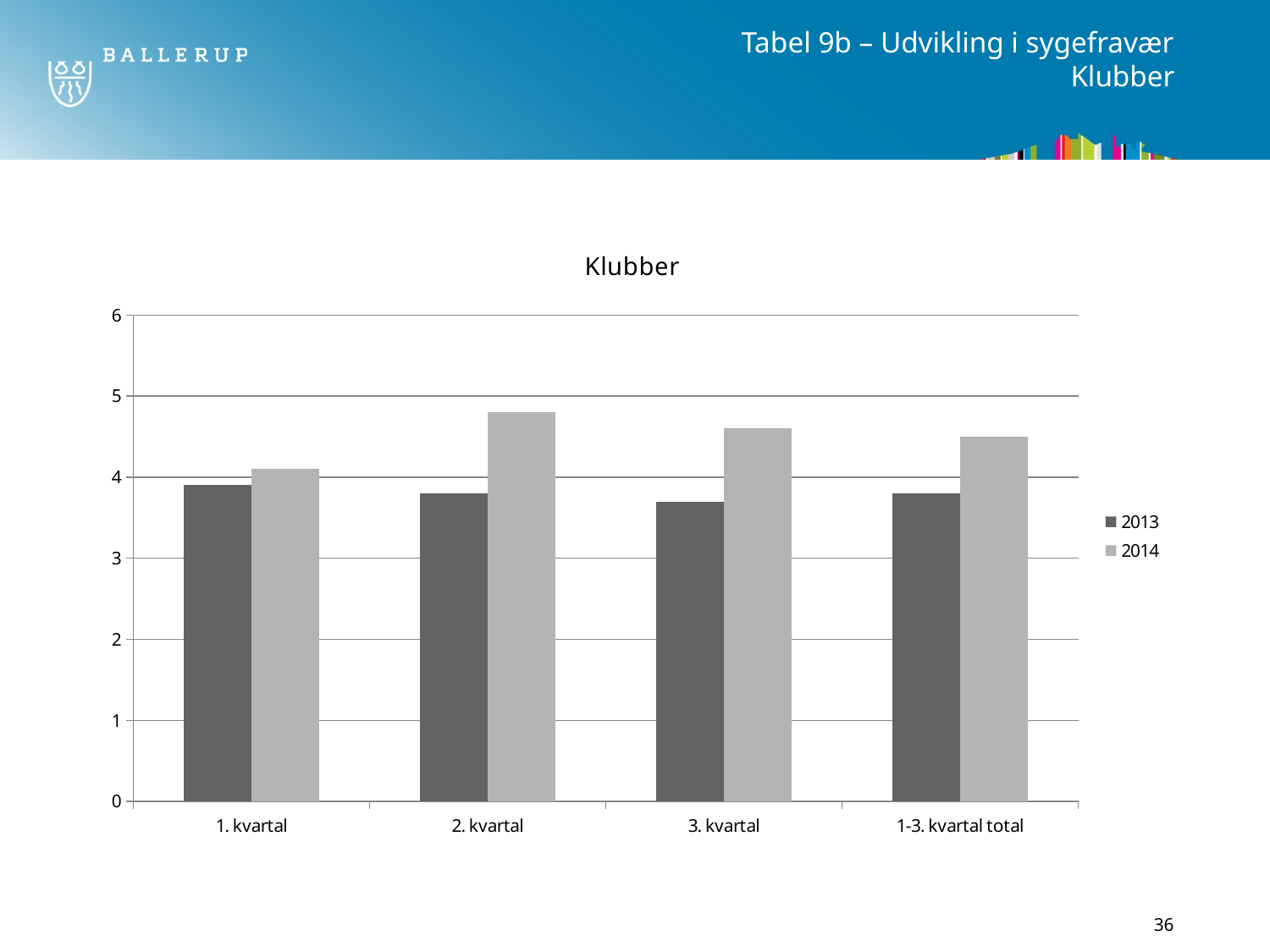
In which category is the 2014 value lowest? 1. kvartal Which series are listed in the legend? 2013 and 2014 Does the 2014 value rise or fall from 2. kvartal to 3. kvartal? fall In which category is the 2014 value highest? 2. kvartal For 2. kvartal, which is larger: the 2013 value or the 2014 value? 2014 Is the 2014 value for 2. kvartal greater or less than 5? less What kind of chart is shown on the slide? bar chart What is the title of the chart? Klubber How many series does the legend list? 2 How many categories are shown on the x axis? 4 Is the 2013 value for 3. kvartal greater or less than 4? less Is the 2014 value for 2. kvartal greater or less than 4? greater